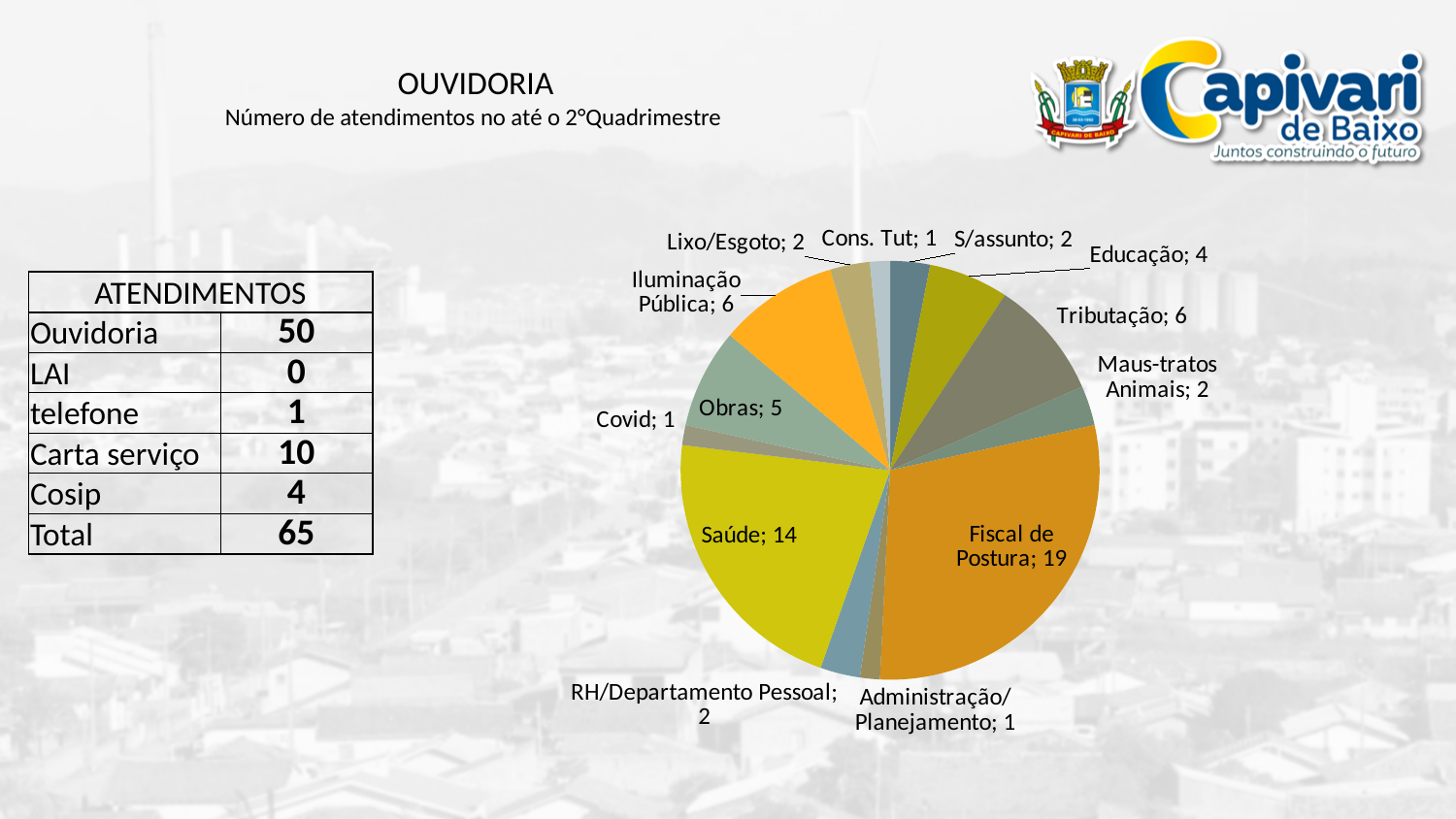
Which category has the largest slice in the pie chart? Fiscal de Postura What is the difference between the values for Fiscal de Postura and Saúde? 5 What is the total of all the slice values in the pie chart? 65 Which is larger, Obras or Lixo/Esgoto? Obras How many categories (slices) does the pie chart show? 13 What is the value for Saúde in the pie chart? 14 What is the value for Educação in the pie chart? 4 What is the value for Obras in the pie chart? 5 What is the value for Iluminação Pública in the pie chart? 6 Which is larger, Tributação or Educação? Tributação What kind of chart is shown on the slide? Pie chart What is the value for Fiscal de Postura in the pie chart? 19